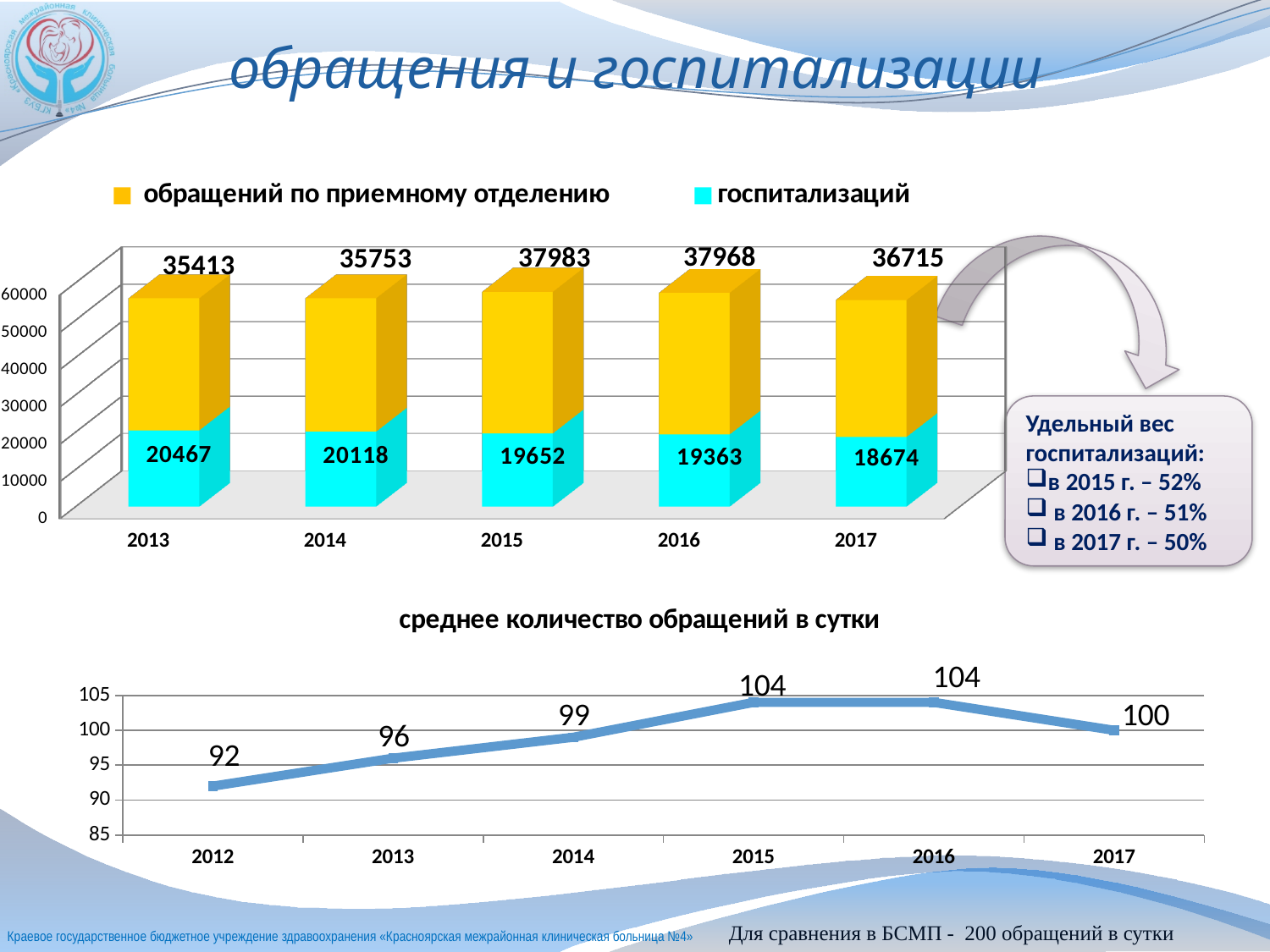
In the top chart, which year has the lowest value for госпитализаций? 2017 In the top chart, what is the value for обращений по приемному отделению in 2017? 36715 In the top chart, which year has the highest value for обращений по приемному отделению? 2015 In the chart titled 'среднее количество обращений в сутки', how many years are plotted on the x axis? 6 What kind of chart is the chart titled 'среднее количество обращений в сутки'? line chart In the chart titled 'среднее количество обращений в сутки', what is the value for 2014? 99 In the top chart, what is the difference between госпитализаций in 2013 and in 2017? 1793 In the top chart, what is the total of the stacked bar for 2013? 55880 In the top chart, is the value for обращений по приемному отделению larger in 2014 or in 2016? 2016 In the top chart, what is the value for госпитализаций in 2015? 19652 In the top chart, how many series does the legend list? 2 In the chart titled 'среднее количество обращений в сутки', which year has the lowest value? 2012